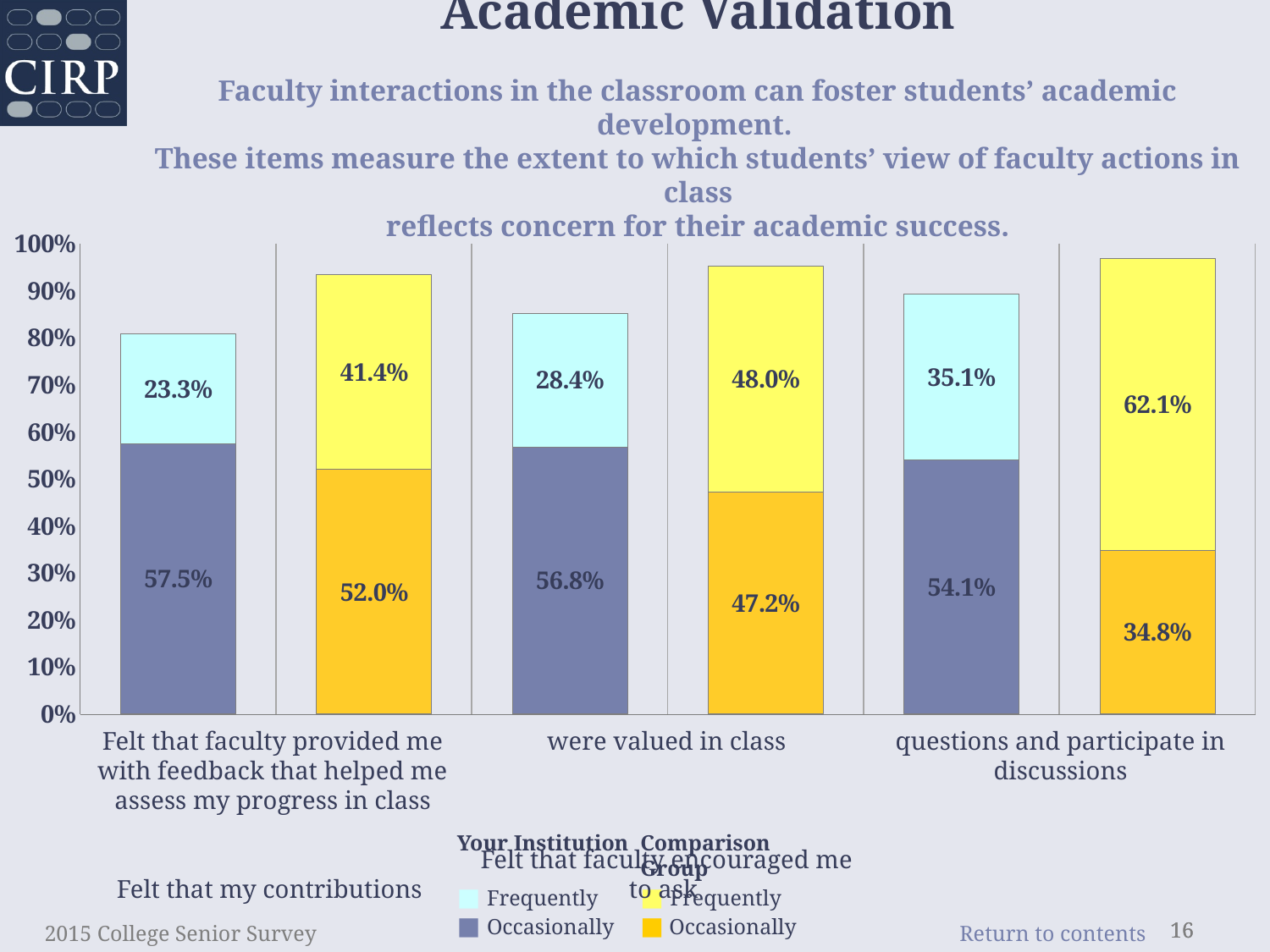
Which category has the lowest Your Institution 'Frequently' value? Felt that faculty provided me with feedback that helped me assess my progress in class How many entries does the legend list? 4 What is the Comparison Group 'Frequently' value for 'Felt that faculty provided me with feedback that helped me assess my progress in class'? 41.4% What is the Comparison Group 'Occasionally' value for the right-hand category (encouraged to ask questions and participate in discussions)? 34.8% Does the Your Institution 'Frequently' value rise or fall moving from the left category to the right category? rise For the middle category, which is larger: the Comparison Group 'Frequently' value or the Comparison Group 'Occasionally' value? Frequently (48.0%) What is the Your Institution 'Occasionally' value for 'Felt that faculty provided me with feedback that helped me assess my progress in class'? 57.5% What is the total height of the Your Institution stacked bar for 'Felt that faculty provided me with feedback that helped me assess my progress in class'? 80.8% What type of chart is shown on the slide? stacked bar chart Which category has the highest Comparison Group 'Frequently' value? questions and participate in discussions (right-hand category) What is the Your Institution 'Frequently' value for the middle category (contributions were valued in class)? 28.4% What is the difference between the Comparison Group 'Frequently' value (62.1%) and the Your Institution 'Frequently' value (35.1%) for the right-hand category? 27.0%